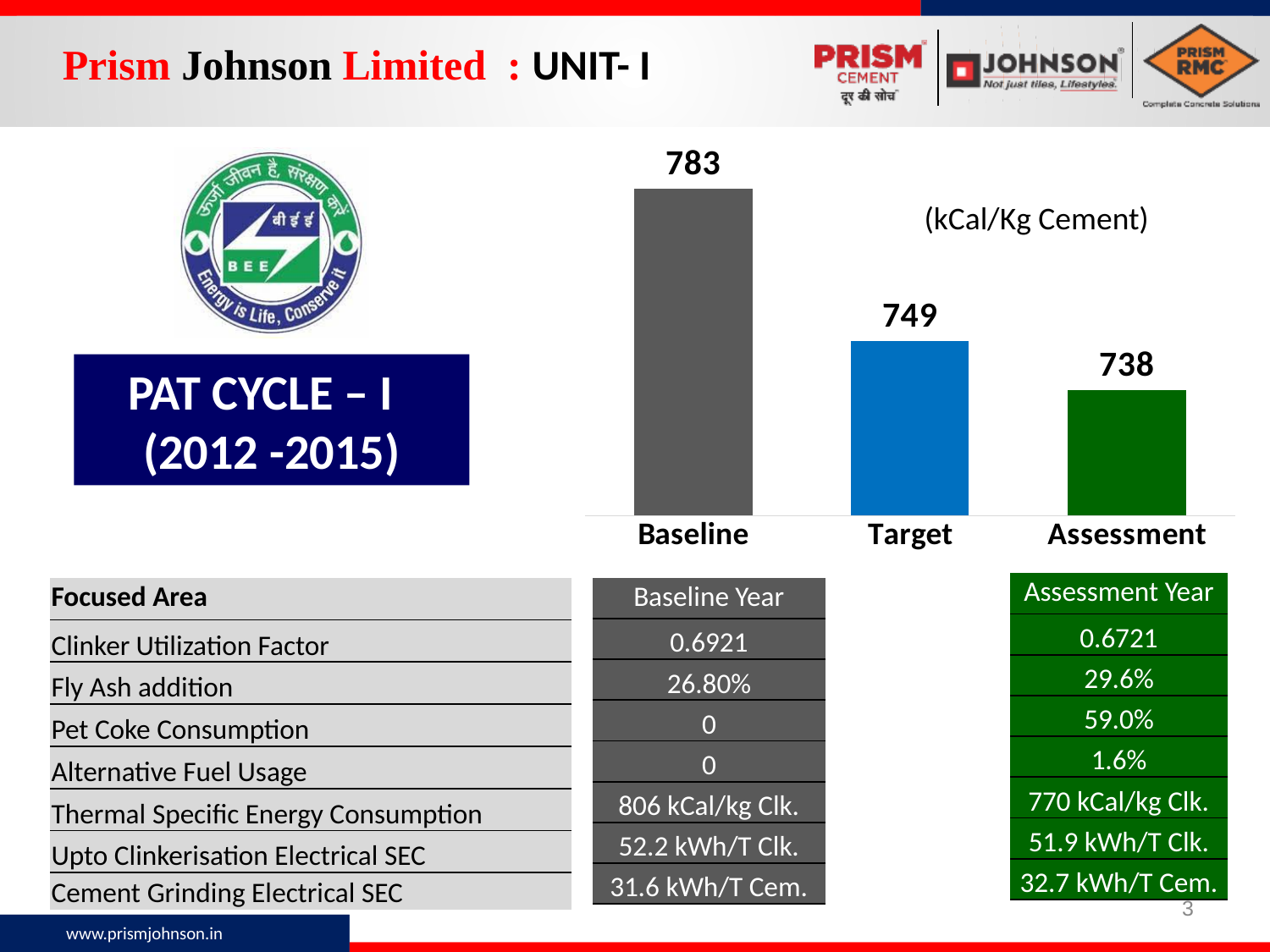
What kind of chart is shown on the slide? Bar chart What is the difference between the Target and Assessment values in the bar chart? 11 Do the values rise or fall from Baseline to Assessment in the bar chart? Fall Which category has the highest value in the bar chart? Baseline Which category has the lowest value in the bar chart? Assessment What is the value for Assessment in the bar chart? 738 Which is larger in the bar chart, Target or Assessment? Target How many categories are shown in the bar chart? 3 What unit is shown for the values in the bar chart? kCal/Kg Cement What is the difference between the Baseline and Assessment values in the bar chart? 45 What is the value for Target in the bar chart? 749 What is the value for Baseline in the bar chart? 783